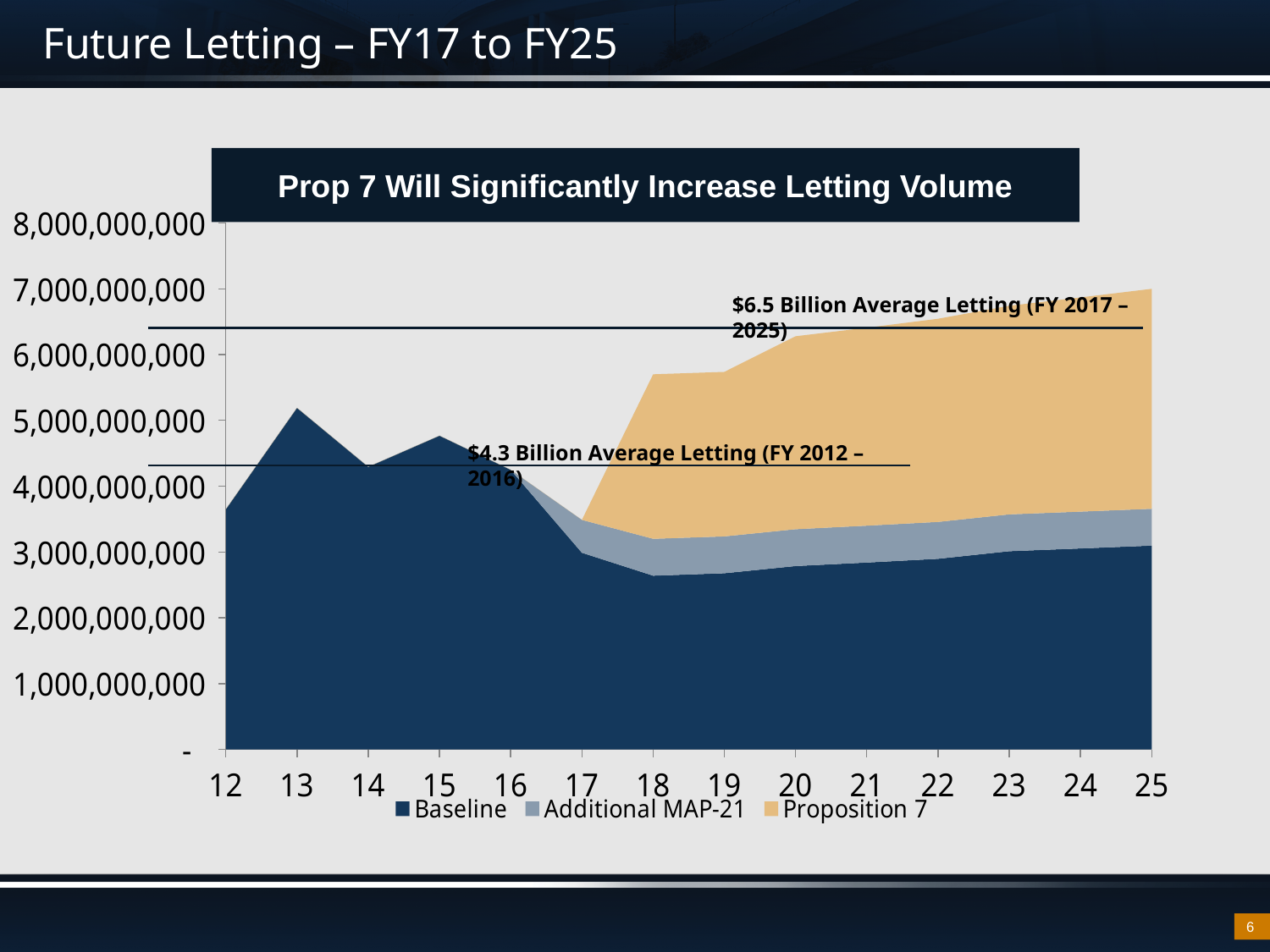
Which series is shown in the tan/gold colour in the legend? Proposition 7 Is the total stacked value for year 25 greater or less than 6,000,000,000? greater Is the Baseline value for year 18 greater or less than 3,000,000,000? less What is the title of the chart? Prop 7 Will Significantly Increase Letting Volume How many series does the chart legend list? 3 Does the total stacked value rise or fall from year 18 to year 25? rise What kind of chart is shown on the slide? Stacked area chart Is the total stacked value for year 17 greater or less than 4,000,000,000? less Which is larger, the Baseline value for year 13 or for year 15? 13 How many fiscal years are plotted along the x axis? 14 In which year does the Baseline series reach its highest value? 13